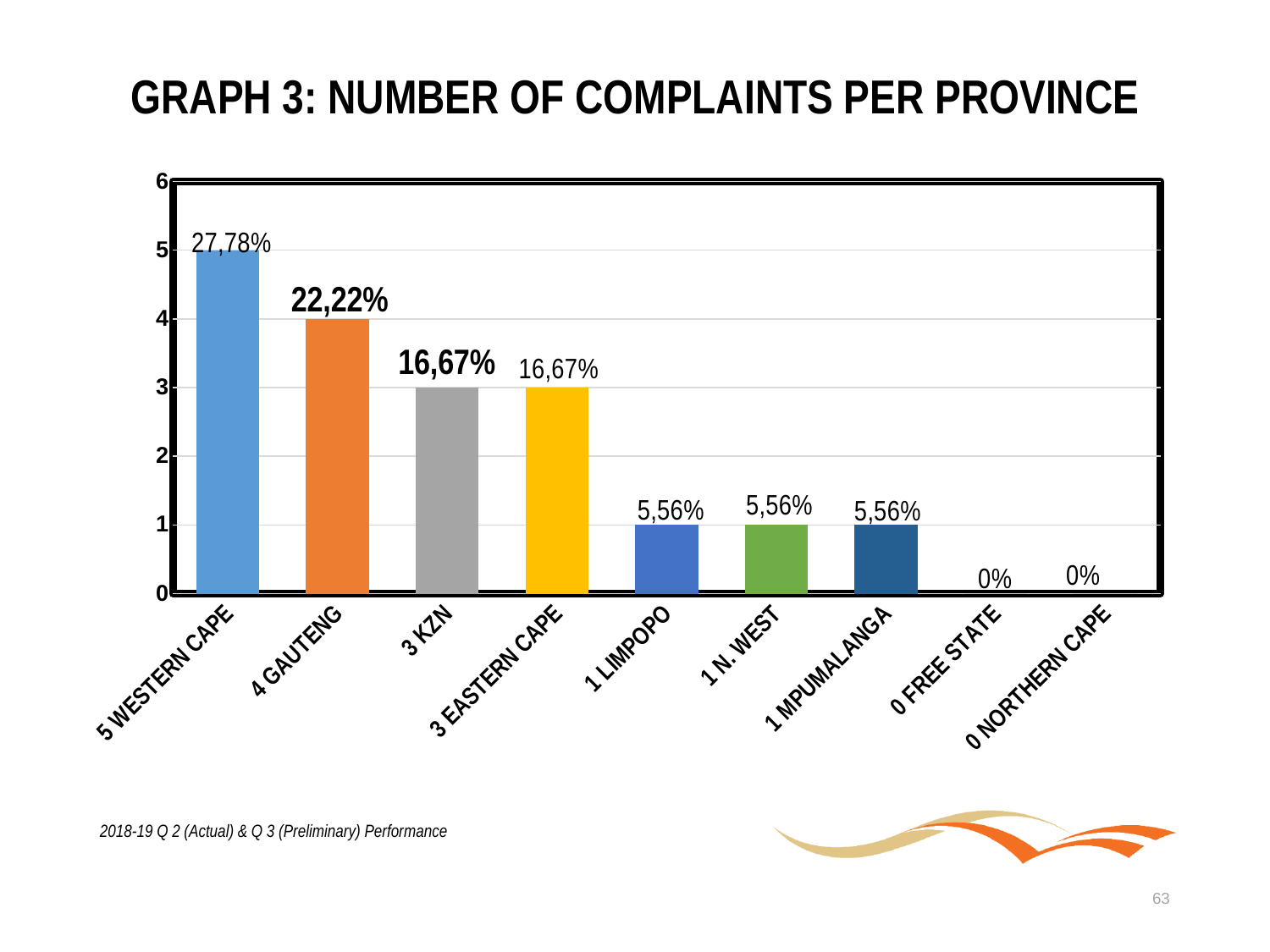
Which province has the highest number of complaints? Western Cape What is the difference in complaints between Western Cape (5) and Gauteng (4)? 1 What percentage label is shown on the bar for Western Cape? 27,78% How many provinces are shown on the x axis of the chart? 9 Which of Gauteng or Eastern Cape has the larger bar? Gauteng What percentage label is shown on the bar for Limpopo? 5,56% What is the title of the chart? GRAPH 3: NUMBER OF COMPLAINTS PER PROVINCE What percentage label is shown on the bar for Gauteng? 22,22% How many complaints does the bar for KZN reach on the y axis? 3 Do the bar values rise or fall from left to right along the x axis? fall What type of chart is shown on the slide? bar chart Is the value for Mpumalanga greater or less than 2? less